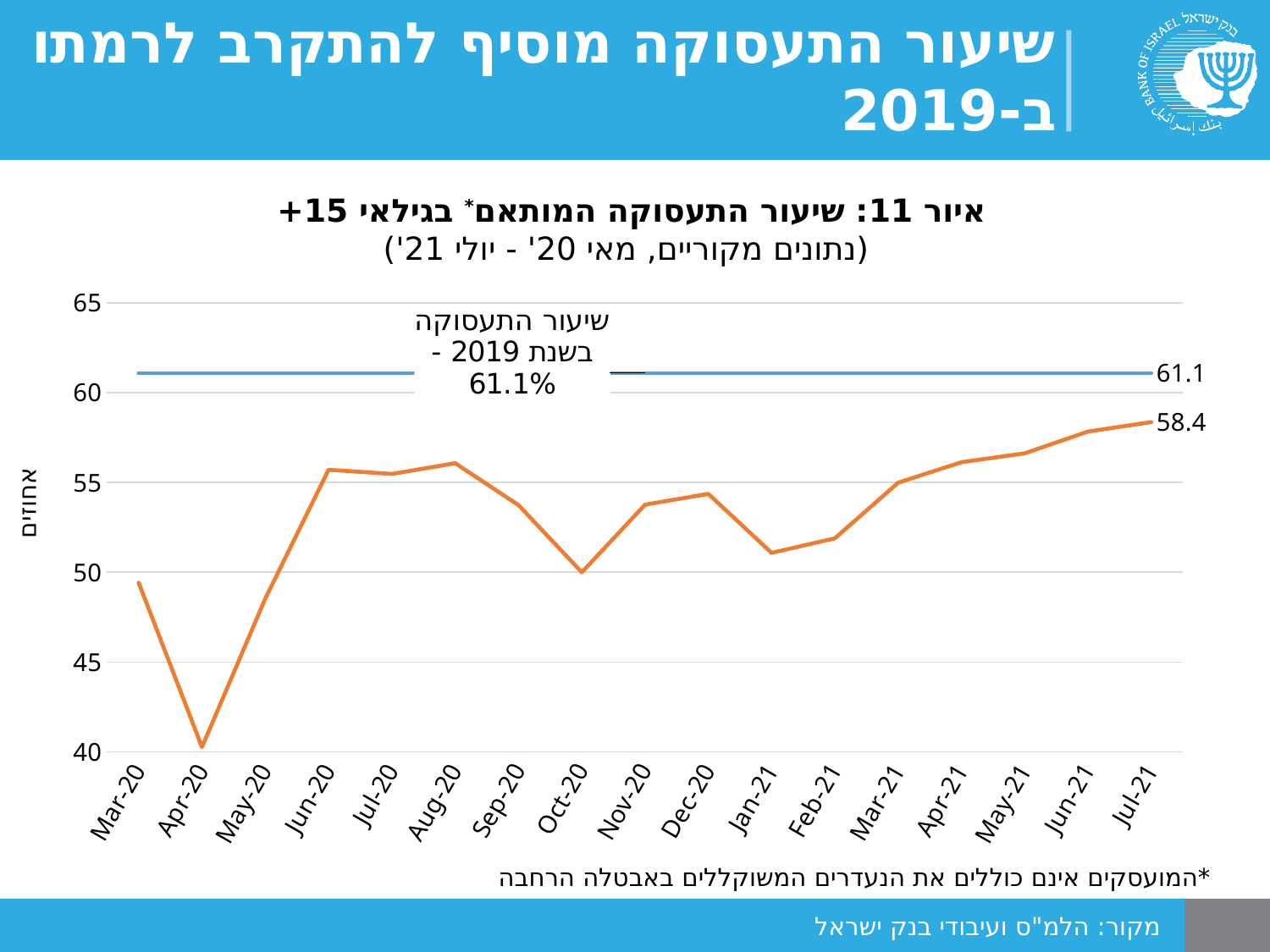
How many months are shown on the x axis? 17 Is the value for Mar-20 greater or less than 45? greater Is the value for Apr-20 greater or less than 45? less Which month has the lowest employment rate on the orange line? Apr-20 What kind of chart is shown on the slide? line chart What value does the horizontal reference line for the 2019 employment rate show? 61.1 Which is larger, the employment rate in Jun-20 or in Oct-20? Jun-20 What is the value of the employment rate for Jul-21? 58.4 Is the value for Oct-20 greater or less than 55? less Does the employment rate rise or fall from Mar-21 to Jul-21? rise What is the difference between the 2019 employment rate (61.1) and the Jul-21 value (58.4)? 2.7 Which month has the highest employment rate on the orange line? Jul-21